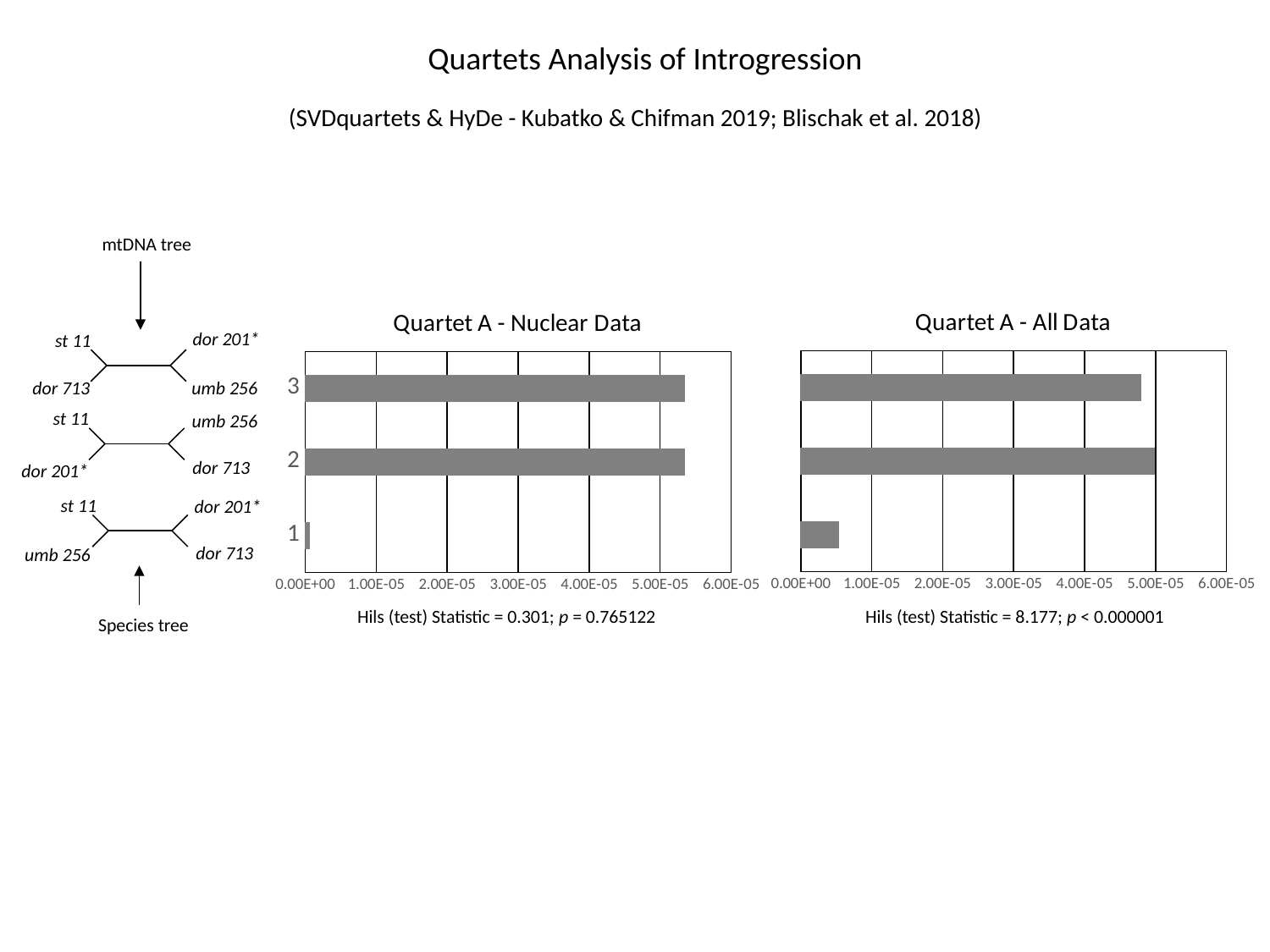
What kind of chart is "Quartet A - Nuclear Data"? bar chart What is the highest tick value shown on the x axis of the "Quartet A - Nuclear Data" chart? 6.00E-05 In the "Quartet A - Nuclear Data" chart, which is larger, the value for category 1 or category 3? category 3 How many categories are plotted in the "Quartet A - All Data" chart? 3 In the "Quartet A - Nuclear Data" chart, which category has the lowest value? 1 In the "Quartet A - All Data" chart, which is larger, the value for category 2 or category 1? category 2 In the "Quartet A - Nuclear Data" chart, is the value for category 1 greater or less than 1.00E-05? less In the "Quartet A - All Data" chart, which category has the lowest value? 1 In the "Quartet A - Nuclear Data" chart, is the value for category 3 greater or less than 5.00E-05? greater In the "Quartet A - All Data" chart, is the value for category 3 greater or less than 4.00E-05? greater What is the title of the chart on the right side of the slide? Quartet A - All Data